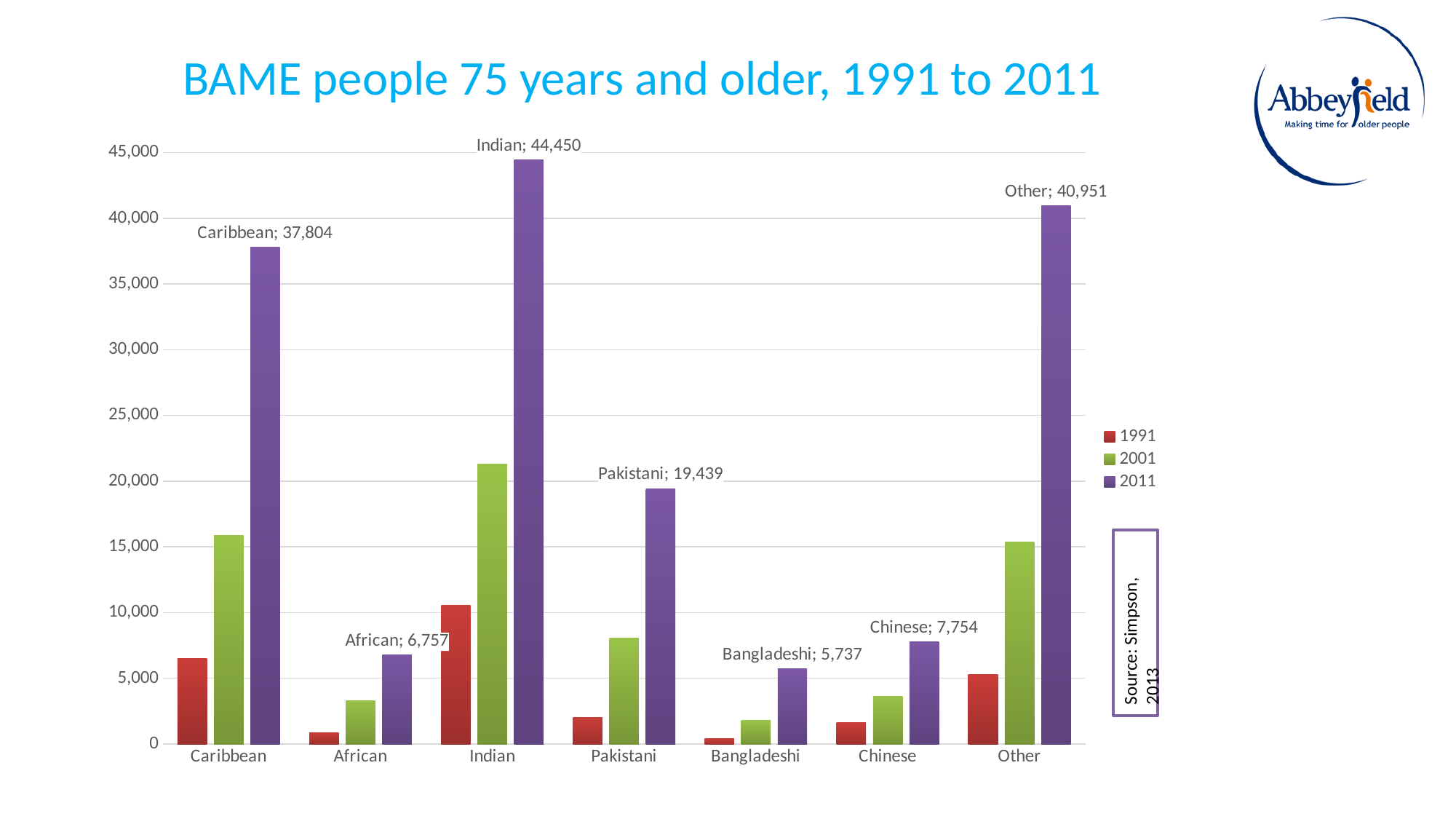
How many series does the legend list? 3 In the 2011 series, which is larger: Caribbean or Other? Other What is the difference between the 2011 values for Indian and Other? 3,499 Is the 2001 value for Indian greater or less than 20,000? greater What is the value for Other in the 2011 series? 40,951 How many categories are shown on the x axis? 7 Which category has the lowest value in the 2011 series? Bangladeshi What kind of chart is shown on the slide? Bar chart What is the value for Indian in the 2011 series? 44,450 Is the 2001 value for Pakistani greater or less than 10,000? less Which category has the highest value in the 2011 series? Indian What is the value for Bangladeshi in the 2011 series? 5,737